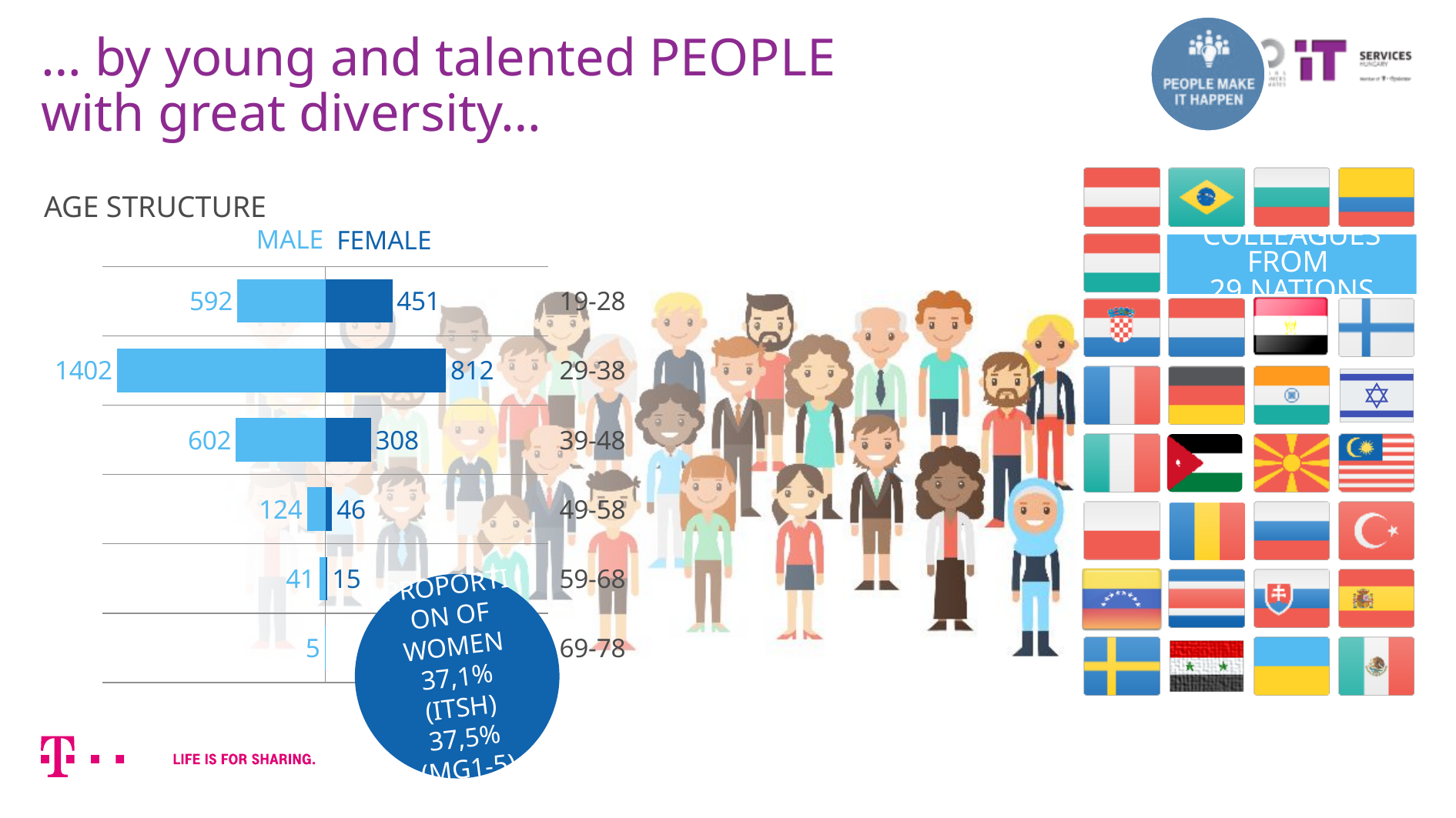
What is the MALE value for the 59-68 age group? 41 How many age groups are shown in the AGE STRUCTURE chart? 6 Is the MALE value for the 39-48 age group larger than the MALE value for the 19-28 age group? Yes What is the FEMALE value for the 39-48 age group? 308 What kind of chart is the AGE STRUCTURE chart? bar chart What is the title of the chart on the slide? AGE STRUCTURE How many series does the AGE STRUCTURE chart show? 2 Which age group has the highest MALE value? 29-38 Which age group has the lowest FEMALE value among those with a printed label? 59-68 What is the MALE value for the 29-38 age group? 1402 What is the difference between the MALE and FEMALE values for the 29-38 age group? 590 What is the FEMALE value for the 19-28 age group? 451